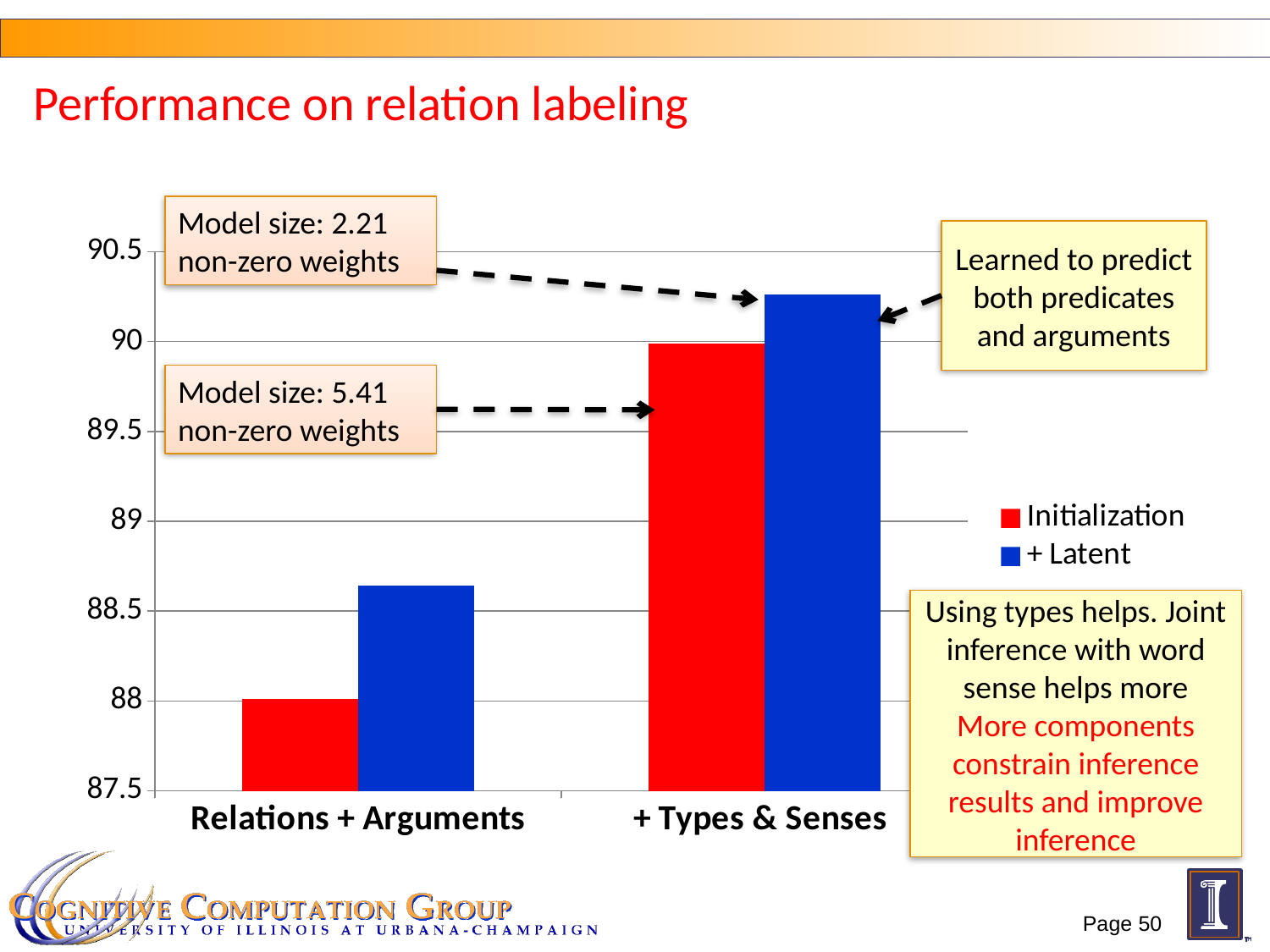
Is the + Latent value for Relations + Arguments greater or less than 88.5? greater Which colour represents the + Latent series in the chart? blue Which category has the highest + Latent bar? + Types & Senses Which category has the lowest Initialization bar? Relations + Arguments For + Types & Senses, which series has the larger value, Initialization or + Latent? + Latent How many categories are shown on the x axis of the chart? 2 How many series does the chart's legend list? 2 Is the Initialization value for + Types & Senses greater or less than 89.5? greater What kind of chart is shown on the slide? bar chart Which is larger: the + Latent value for Relations + Arguments or the Initialization value for + Types & Senses? Initialization value for + Types & Senses Is the + Latent value for + Types & Senses greater or less than 90? greater